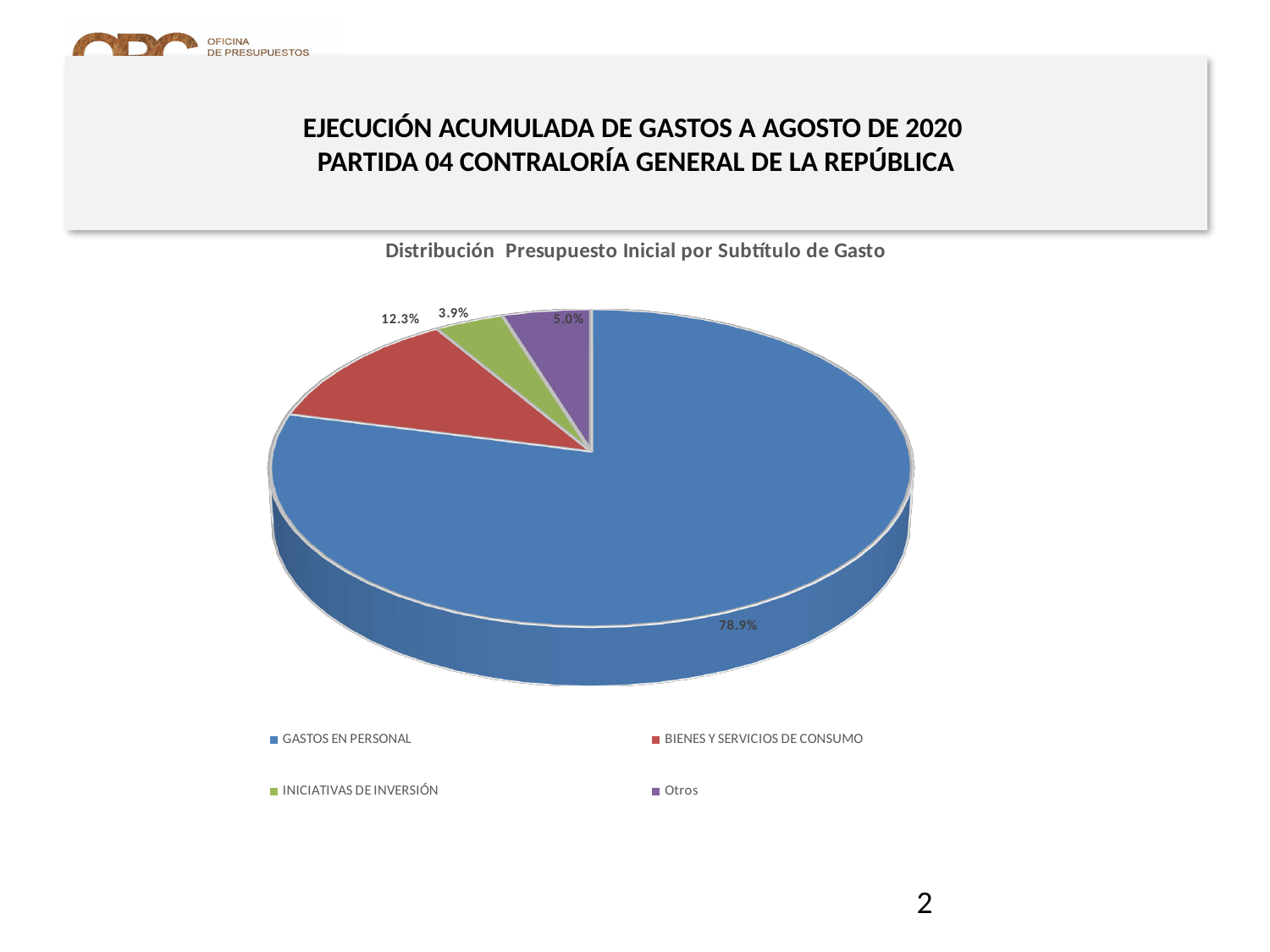
What is the chart's title? Distribución Presupuesto Inicial por Subtítulo de Gasto What share of the pie does GASTOS EN PERSONAL represent? 78.9% What is the difference in percentage points between GASTOS EN PERSONAL and BIENES Y SERVICIOS DE CONSUMO? 66.6 What share of the pie does BIENES Y SERVICIOS DE CONSUMO represent? 12.3% Which category has the largest slice of the pie? GASTOS EN PERSONAL How many categories does the pie chart show? 4 Which is larger, the share for Otros or the share for INICIATIVAS DE INVERSIÓN? Otros What colour is the slice for BIENES Y SERVICIOS DE CONSUMO? Red Which category has the smallest slice of the pie? INICIATIVAS DE INVERSIÓN What share of the pie does INICIATIVAS DE INVERSIÓN represent? 3.9% What kind of chart is shown on the slide? Pie chart